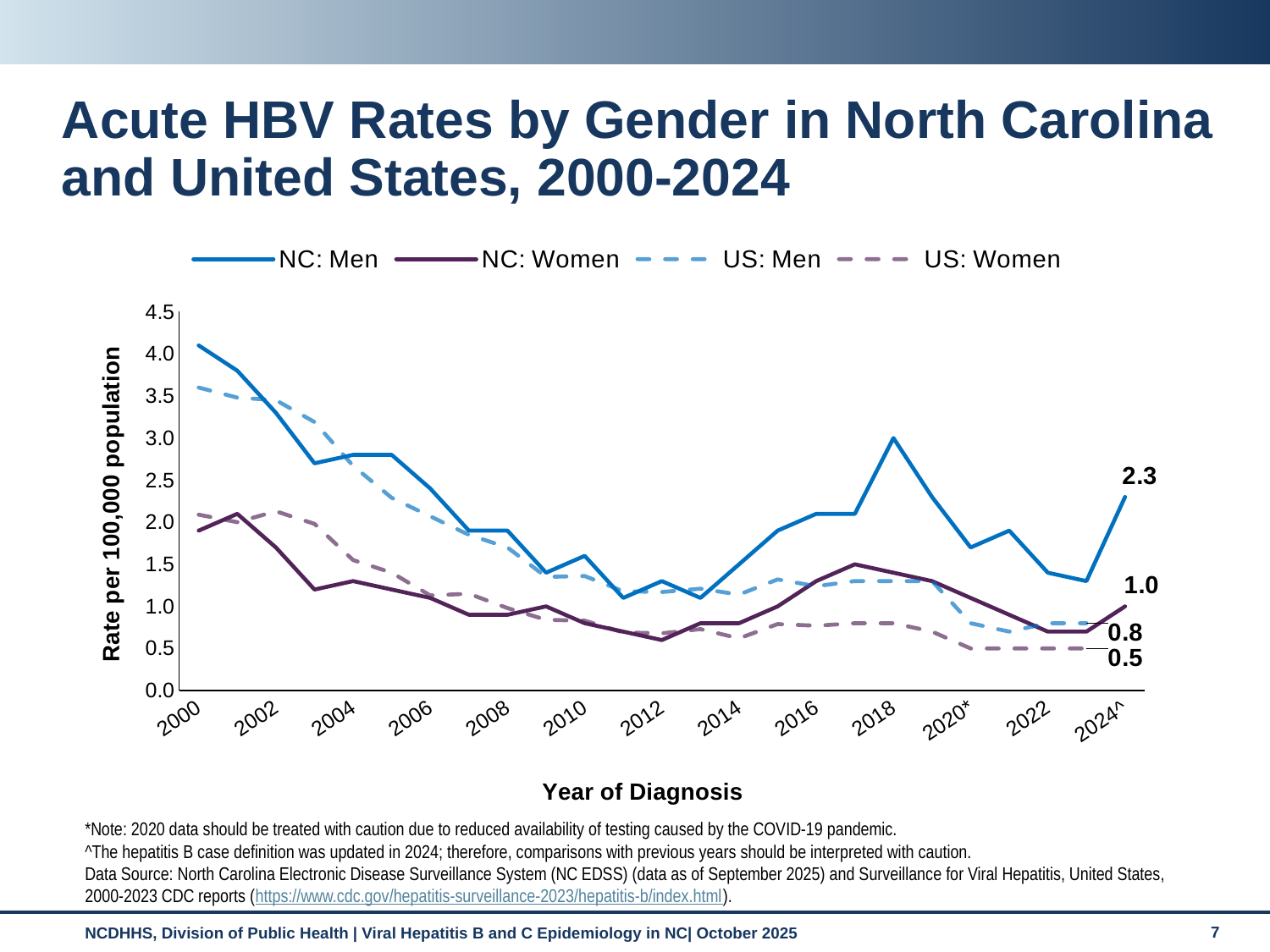
What is the labeled value for NC: Women at the end of the series in 2024? 1.0 Which series has the higher labeled value in 2024, NC: Men or NC: Women? NC: Men What is the labeled value at the end of the US: Women series? 0.5 Is the value for NC: Men in 2000 greater or less than 3.5? greater What is the labeled value at the end of the US: Men series? 0.8 Does the NC: Men series generally rise or fall from 2000 to 2012? fall What is the labeled value for NC: Men at the end of the series in 2024? 2.3 Is the value for NC: Women in 2012 greater or less than 1.0? less What is the title of the vertical axis? Rate per 100,000 population What kind of chart is shown on the slide? line chart What is the difference between the 2024 labeled values for NC: Men and NC: Women? 1.3 How many series does the legend list? 4